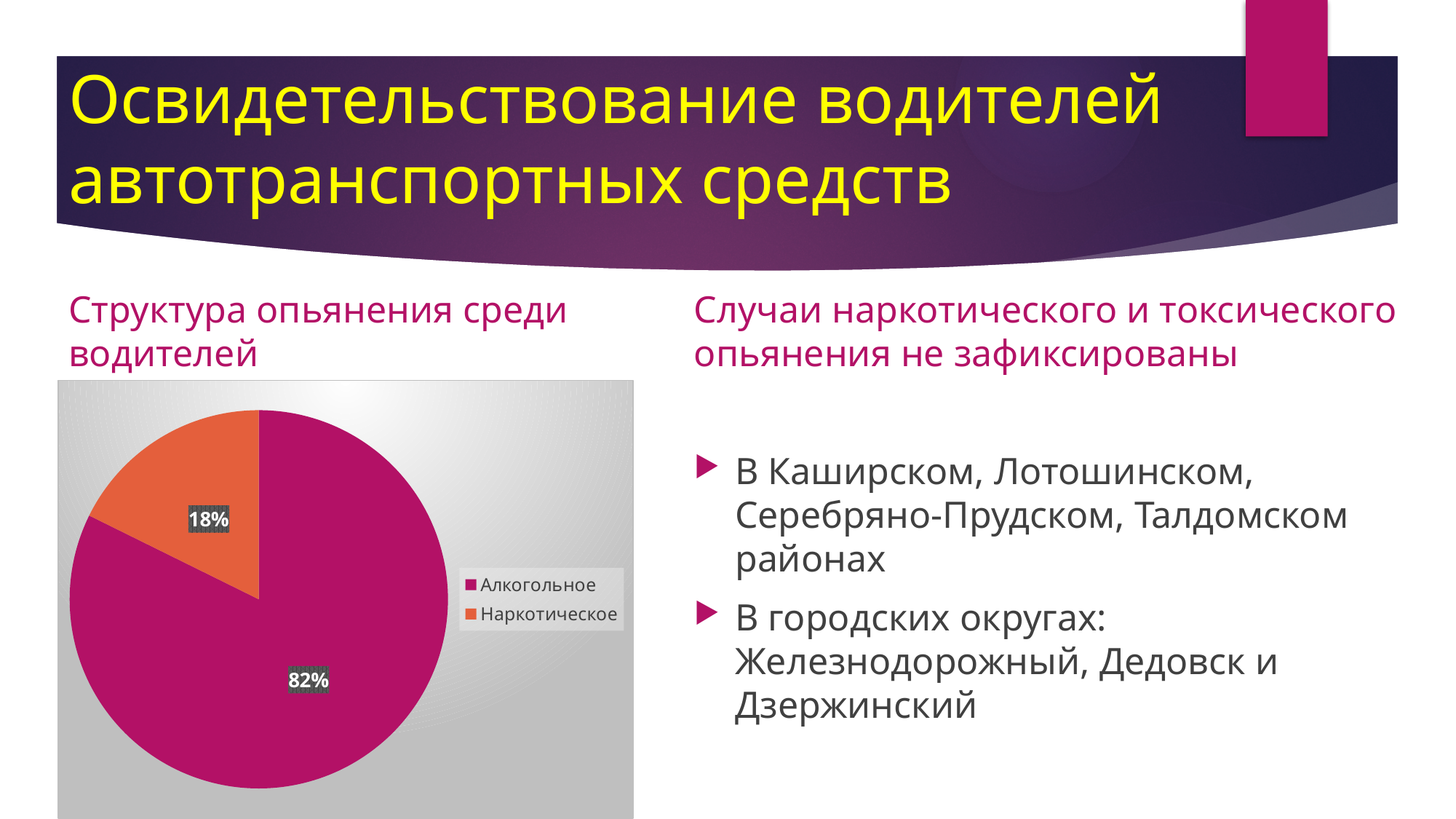
Which category has the largest slice of the pie? Алкогольное What is the title of the chart? Структура опьянения среди водителей How many categories does the pie chart show? 2 What is the difference in percentage points between the Алкогольное and Наркотическое slices? 64 What kind of chart is shown on the slide? pie chart What colour is the Наркотическое slice? orange Which slice is larger, Алкогольное or Наркотическое? Алкогольное What share of the pie does Алкогольное account for? 82% What share of the pie does Наркотическое account for? 18% Which category has the smallest slice of the pie? Наркотическое How many entries does the legend list? 2